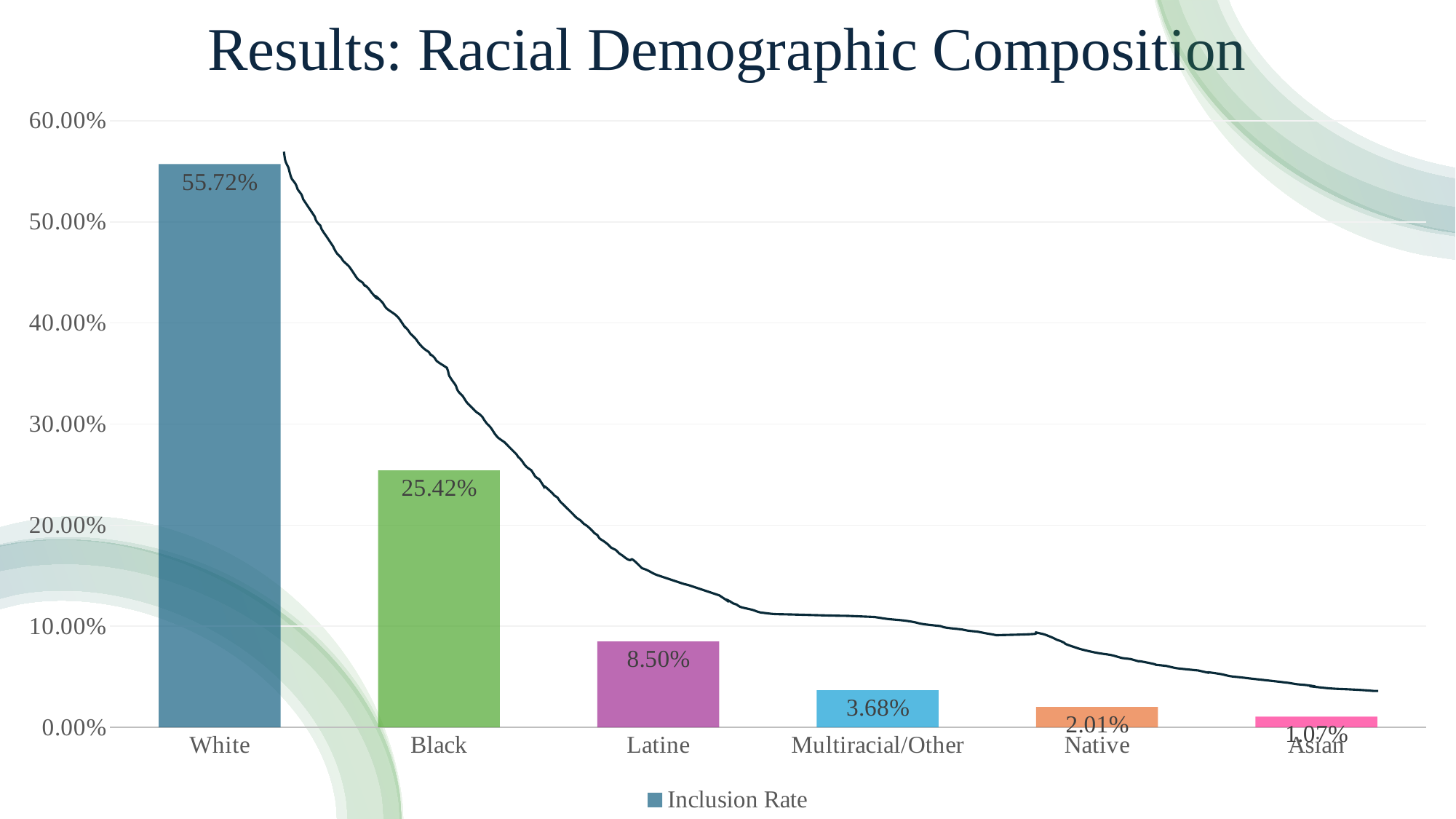
Which category has the lowest inclusion rate? Asian What is the inclusion rate for White? 55.72% What is the inclusion rate for Black? 25.42% What is the inclusion rate for Native? 2.01% How many categories are shown on the x axis? 6 Which category has the highest inclusion rate? White What is the inclusion rate for Multiracial/Other? 3.68% What is the difference between the inclusion rates for White and Black? 30.30% What is the inclusion rate for Latine? 8.50% Which has a higher inclusion rate, Latine or Multiracial/Other? Latine What kind of chart is this? Bar chart What is the title of the chart? Results: Racial Demographic Composition